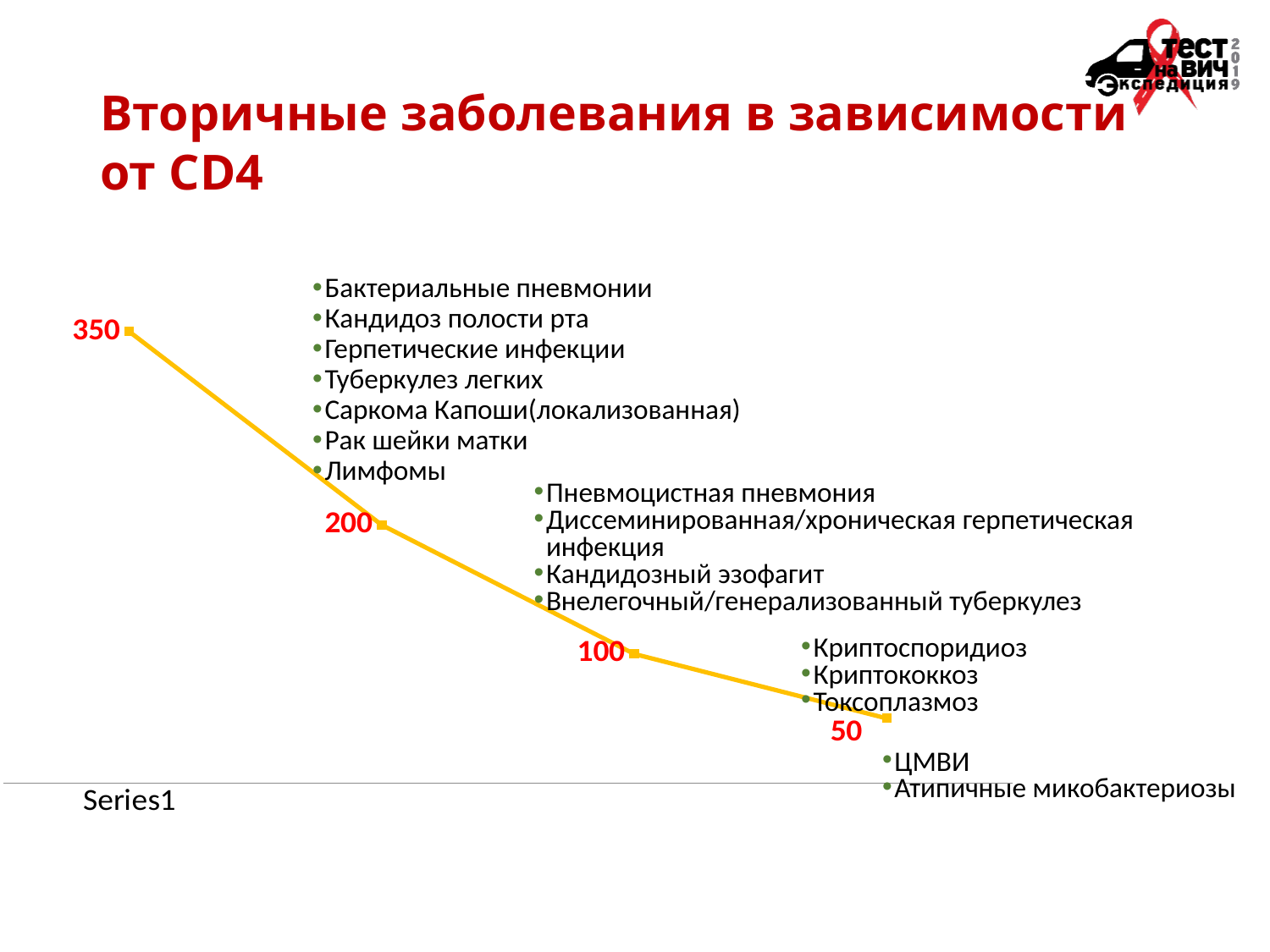
What is the lowest value plotted on the line? 50 What is the value of the second point on the line? 200 Do the values rise or fall from left to right along the line? fall What is the highest value plotted on the line? 350 Which is larger, the value of the first point or the value of the third point? the first point (350) What is the value of the first (leftmost) point on the line? 350 How many data points are plotted on the line? 4 What is the difference between the second point (200) and the third point (100)? 100 What is the value of the last (rightmost) point on the line? 50 What is the title of the slide containing the chart? Вторичные заболевания в зависимости от CD4 What kind of chart is shown on the slide? line chart What is the difference between the first point (350) and the last point (50)? 300